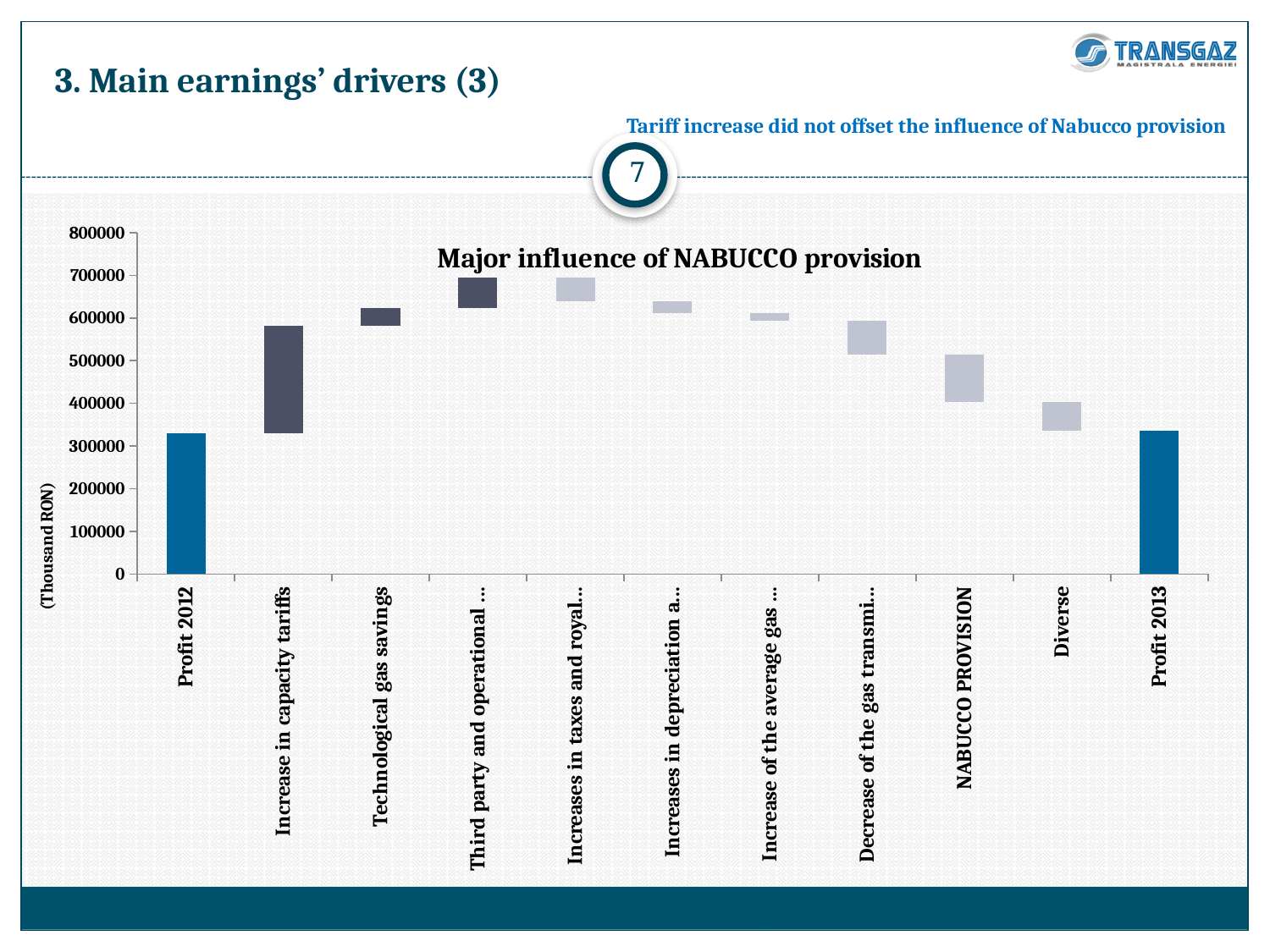
Is the value for Profit 2013 greater or less than 400000? less Which bar is taller: NABUCCO PROVISION or Diverse? NABUCCO PROVISION Is the value for Profit 2013 greater or less than 300000? greater What unit is shown on the vertical axis label of the chart? Thousand RON What kind of chart is shown on the slide? Bar chart Is the value for Profit 2012 greater or less than 400000? less Which bar is taller: Increase in capacity tariffs or NABUCCO PROVISION? Increase in capacity tariffs What is the title of the chart? Major influence of NABUCCO provision How many categories are shown along the x axis of the chart? 11